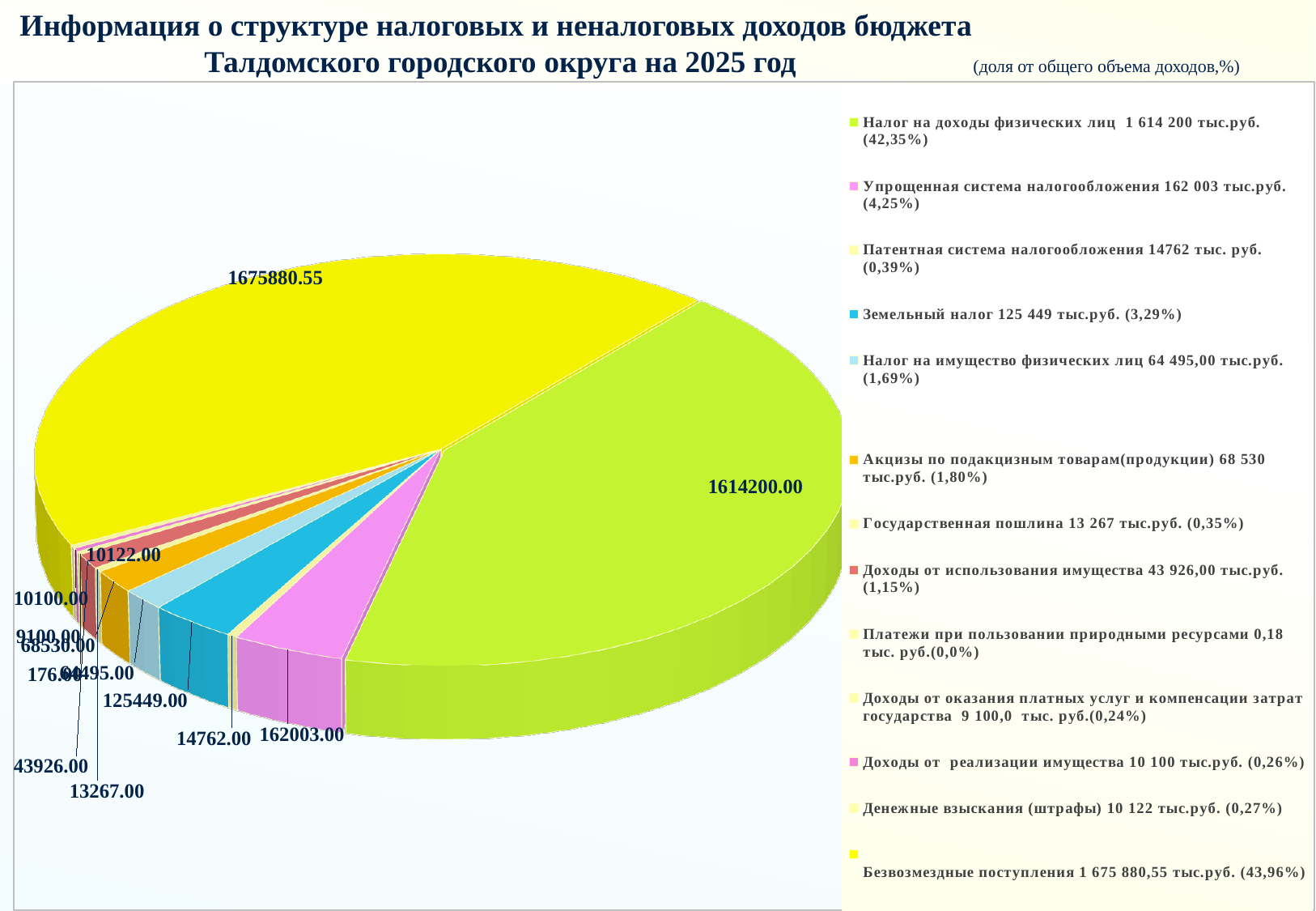
What is the data label value shown for the Земельный налог slice? 125449.00 What share of total revenue does Земельный налог represent according to the legend? 3,29% Which is larger: the value for Упрощенная система налогообложения or the value for Земельный налог? Упрощенная система налогообложения How many categories does the legend of the pie chart list? 13 What is the data label value shown for the Налог на доходы физических лиц slice? 1614200.00 What is the difference between the data label values for Безвозмездные поступления and Налог на доходы физических лиц? 61680.55 Which category has the largest slice of the pie? Безвозмездные поступления Which category has the smallest slice of the pie? Платежи при пользовании природными ресурсами What is the data label value shown for the Упрощенная система налогообложения slice? 162003.00 What kind of chart is shown on the slide? pie chart What share of total revenue does Безвозмездные поступления represent according to the legend? 43,96% What colour is the slice for Налог на доходы физических лиц? light green